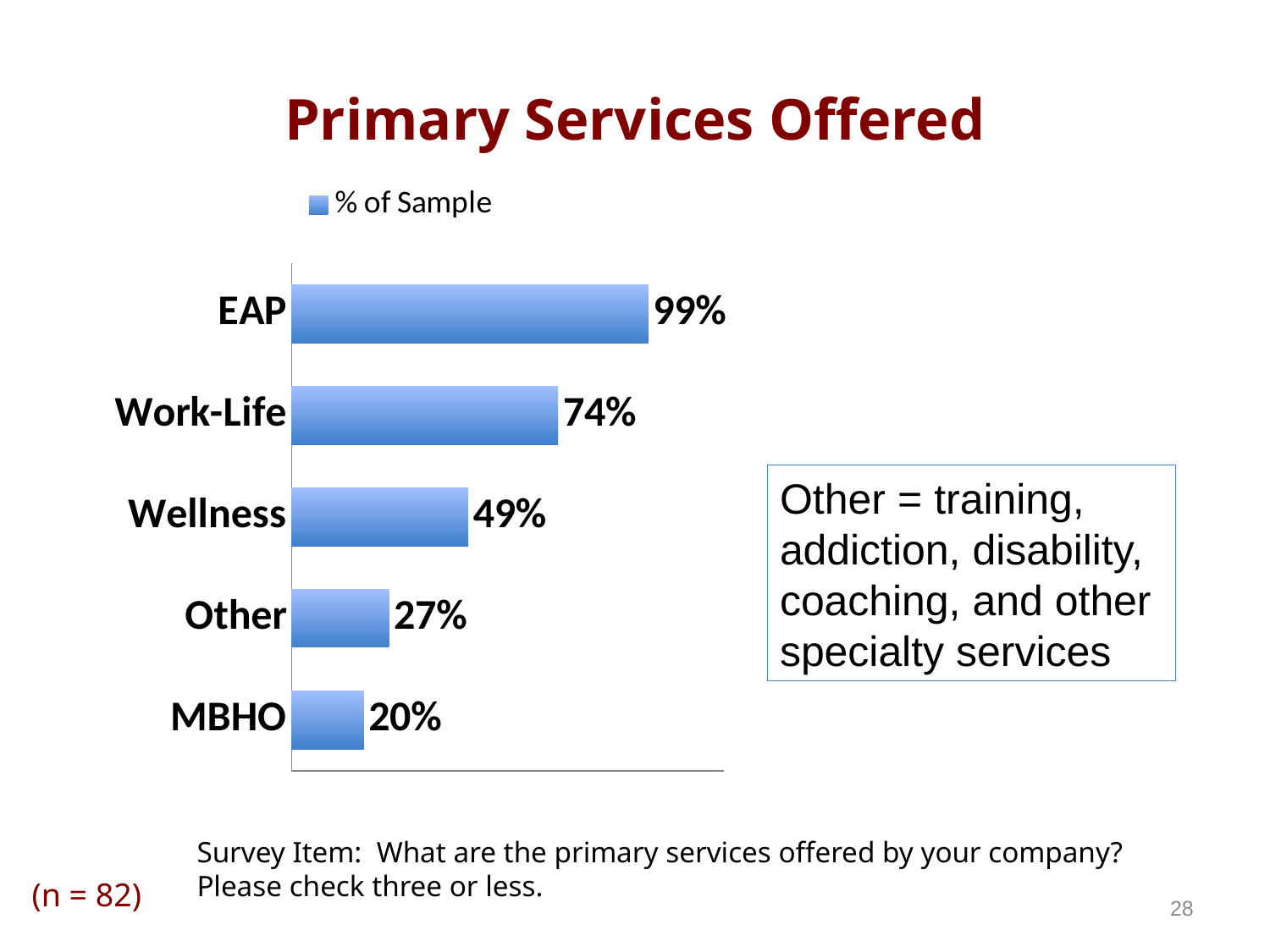
What is the name of the series shown in the legend? % of Sample What is the difference between the values for Other and MBHO? 7% What is the value shown for Work-Life? 74% What is the value shown for Wellness? 49% What percentage of the sample offers EAP as a primary service? 99% Which has a larger value, Wellness or Other? Wellness Which service has the highest percentage of the sample? EAP What type of chart is shown on the slide? Bar chart What is the value shown for MBHO? 20% What is the difference between the values for EAP and Work-Life? 25% How many service categories are shown in the chart? 5 Which service has the lowest percentage of the sample? MBHO